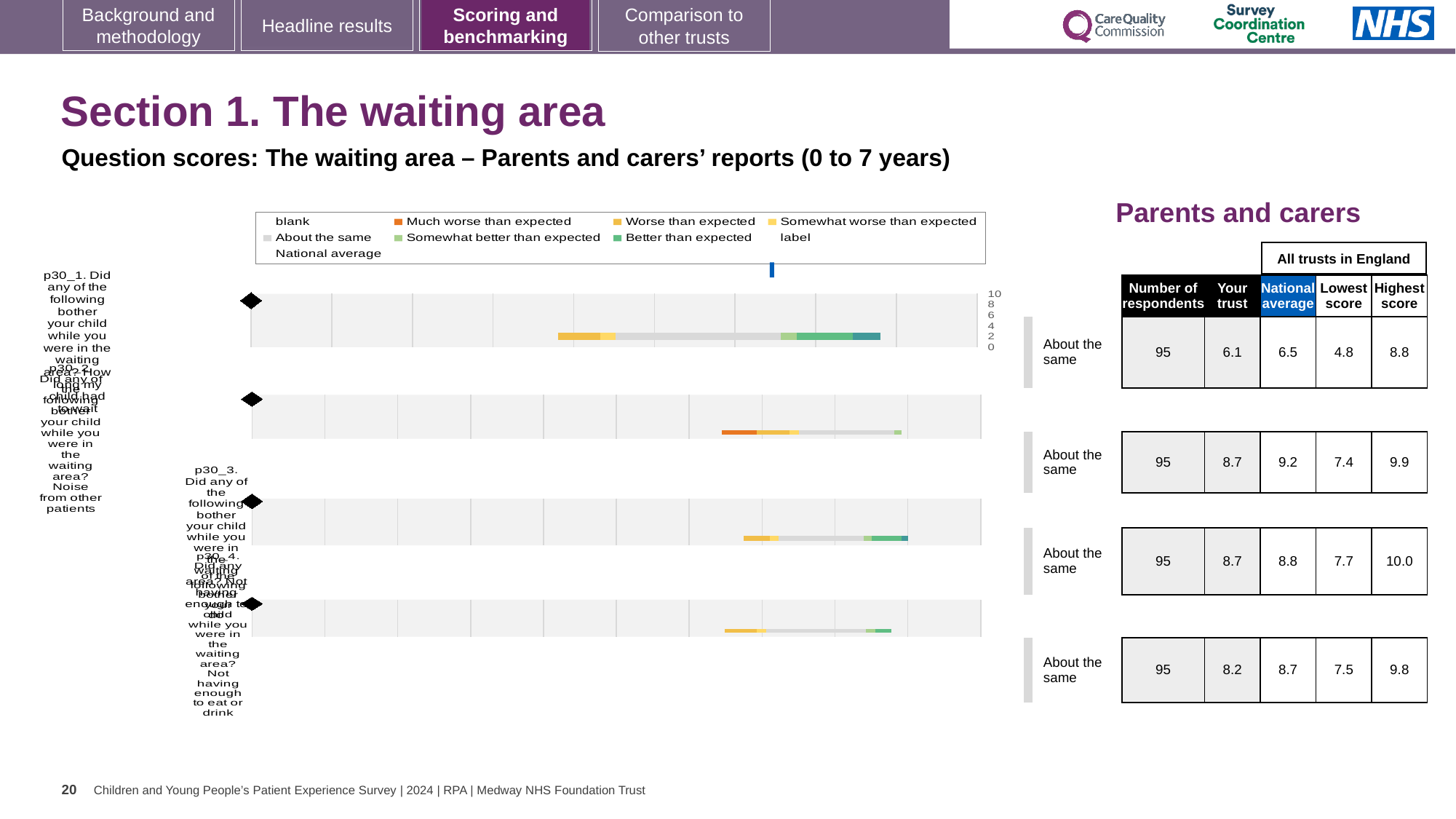
How many horizontal bars (questions) are plotted in the chart? 4 In the table beside the chart, what is the lowest score for the second question (p30_2, noise from other patients)? 7.4 In the table beside the chart, what is the difference between the national average and the 'Your trust' score for the fourth question (p30_4, not having enough to eat or drink)? 0.5 What colour represents 'Much worse than expected' in the chart legend? orange What benchmark category is shown next to each of the four bars? About the same How many entries does the chart legend list? 9 In the table beside the chart, what is the 'Your trust' score for the first question (p30_1, how long my child had to wait)? 6.1 In the table beside the chart, what is the number of respondents for each question? 95 In the table beside the chart, what is the national average for the first question (p30_1)? 6.5 In the table beside the chart, which question has the lowest 'Your trust' score? p30_1 (how long my child had to wait) What kind of chart is shown on the slide? bar chart In the table beside the chart, for the second question (p30_2), which is larger: the 'Your trust' score or the national average? National average